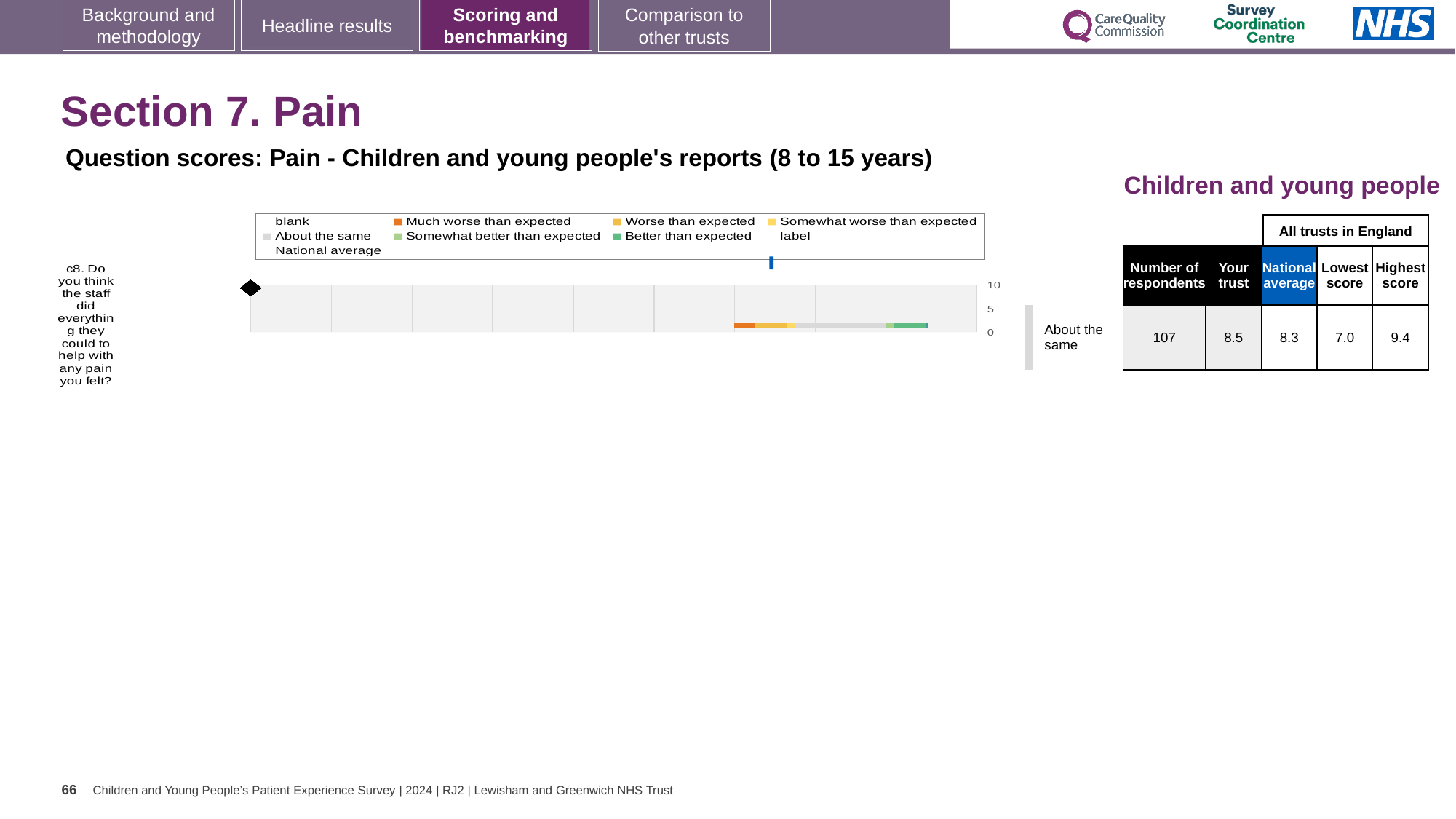
Which survey question is plotted in the chart? c8. Do you think the staff did everything they could to help with any pain you felt? What colour does the legend use for 'Much worse than expected'? orange How many survey questions are plotted in the chart? 1 What is the national average score for question c8 shown in the table next to the chart? 8.3 What benchmark category is the trust's result for question c8 labelled as next to the chart? About the same What is the highest score across all trusts in England for question c8, as shown in the table? 9.4 What is the 'Your trust' score for question c8 shown in the table next to the chart? 8.5 Which is larger for question c8: the 'Your trust' score or the national average? Your trust How many respondents answered question c8, according to the table next to the chart? 107 What is the lowest score across all trusts in England for question c8, as shown in the table? 7.0 What is the difference between the highest score (9.4) and the lowest score (7.0) for question c8 in the table? 2.4 What kind of chart is shown on the slide? bar chart